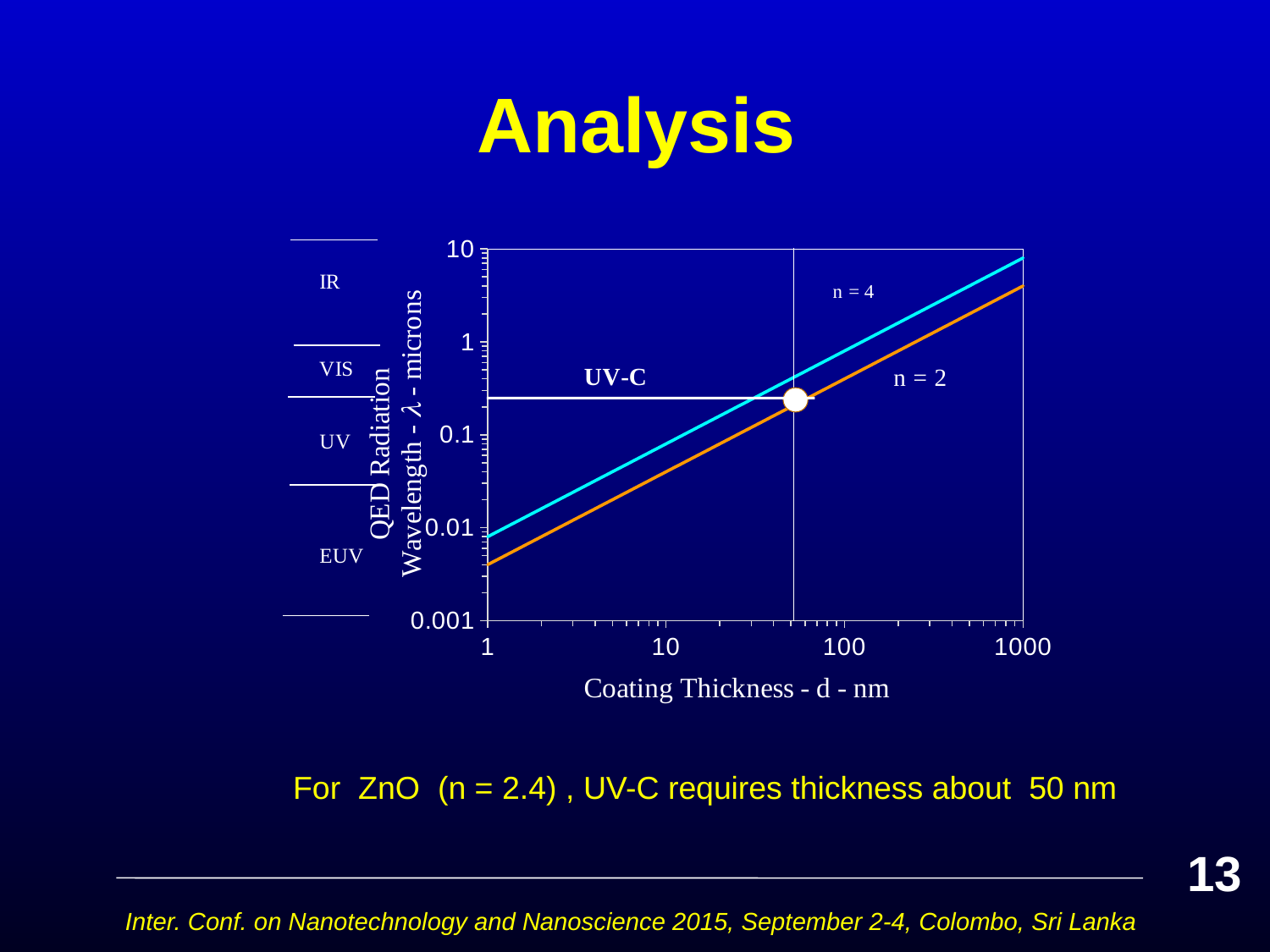
Which line lies lower on the chart across all coating thicknesses, n = 4 or n = 2? n = 2 What kind of chart is shown on the slide? line chart Does the wavelength for the n = 2 line rise or fall as coating thickness increases? rise What is the label of the x axis of the chart? Coating Thickness - d - nm Is the wavelength for the n = 4 line at a coating thickness of 1000 nm greater or less than 1 micron? greater Does the wavelength for the n = 4 line rise or fall as coating thickness increases? rise At a coating thickness of 100 nm, which line has the larger wavelength, n = 4 or n = 2? n = 4 What is the largest coating thickness value shown on the x axis? 1000 Is the wavelength for the n = 2 line at a coating thickness of 1 nm greater or less than 0.01 microns? less Is the wavelength for the n = 2 line at a coating thickness of 10 nm greater or less than 0.1 microns? less What is the label of the y axis of the chart? Wavelength - λ - microns How many lines (series) are plotted on the chart? 2